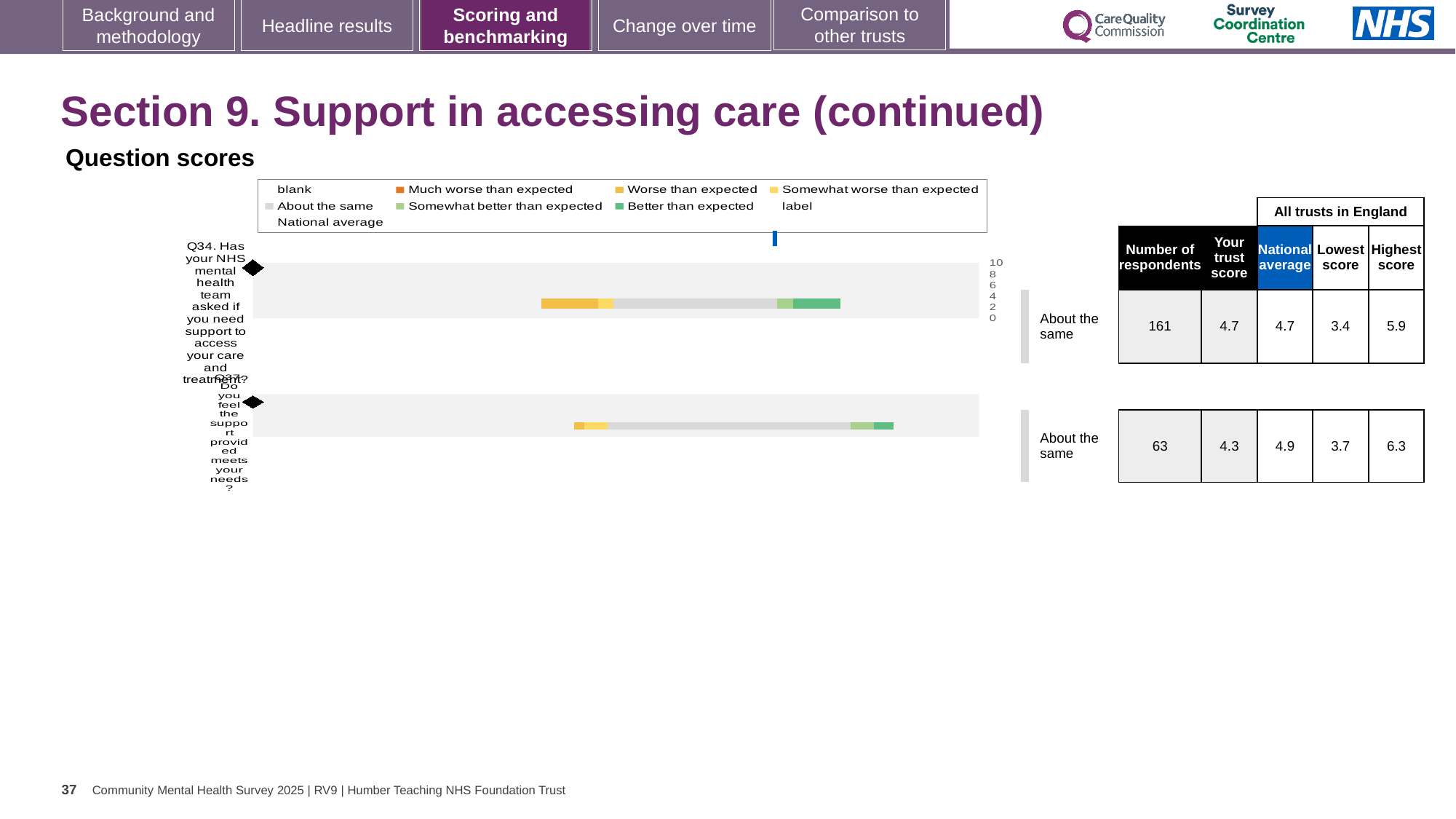
What colour does the legend use for 'Better than expected'? green What benchmark rating is shown for Q34 (Has your NHS mental health team asked if you need support to access your care and treatment)? About the same What is the national average score for Q37? 4.9 What kind of chart is used to show the question scores on this slide? bar chart What is the trust score for Q34? 4.7 What is the trust score for Q37? 4.3 How many questions are plotted in the question scores chart? 2 What is the difference between the highest score and the lowest score for Q37? 2.6 Which question is shown in the top bar of the question scores chart? Q34 Which question has the higher trust score, Q34 or Q37? Q34 What benchmark rating is shown for Q37 (Do you feel the support provided meets your needs)? About the same How many respondents answered Q34? 161